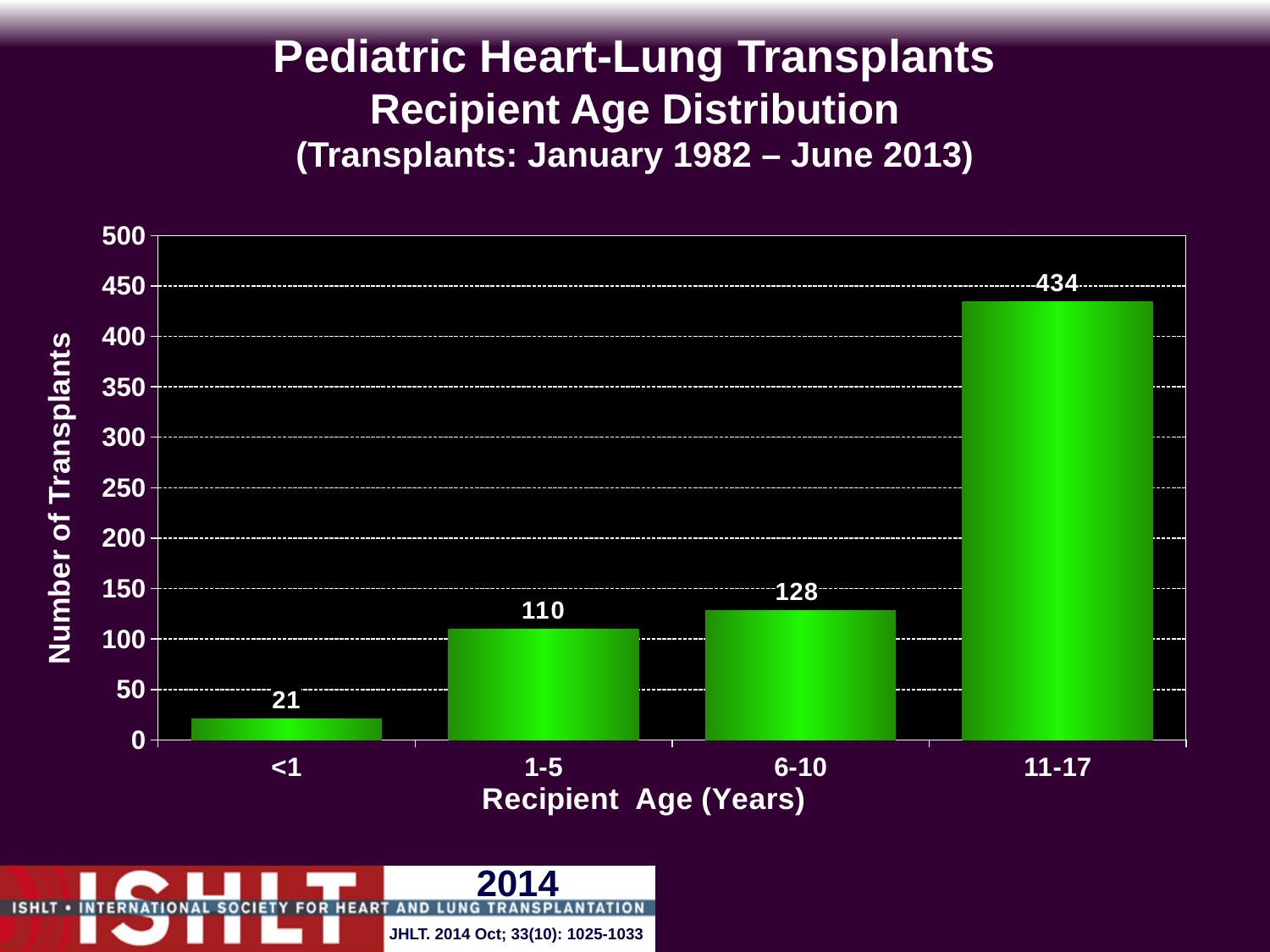
What is the difference in number of transplants between the 11-17 and 6-10 age groups? 306 Is the value for the 1-5 age group greater or less than 150? less What is the number of transplants for the 6-10 age group? 128 Which age group has more transplants, 1-5 or 6-10? 6-10 How many recipient age groups are shown on the chart? 4 What kind of chart is shown on the slide? Bar chart Which recipient age group has the highest number of transplants? 11-17 What is the label of the y axis? Number of Transplants Which recipient age group has the lowest number of transplants? <1 What is the number of transplants for recipients aged <1 year? 21 How many transplants were performed for recipients aged 11-17? 434 What is the difference in number of transplants between the 1-5 and <1 age groups? 89